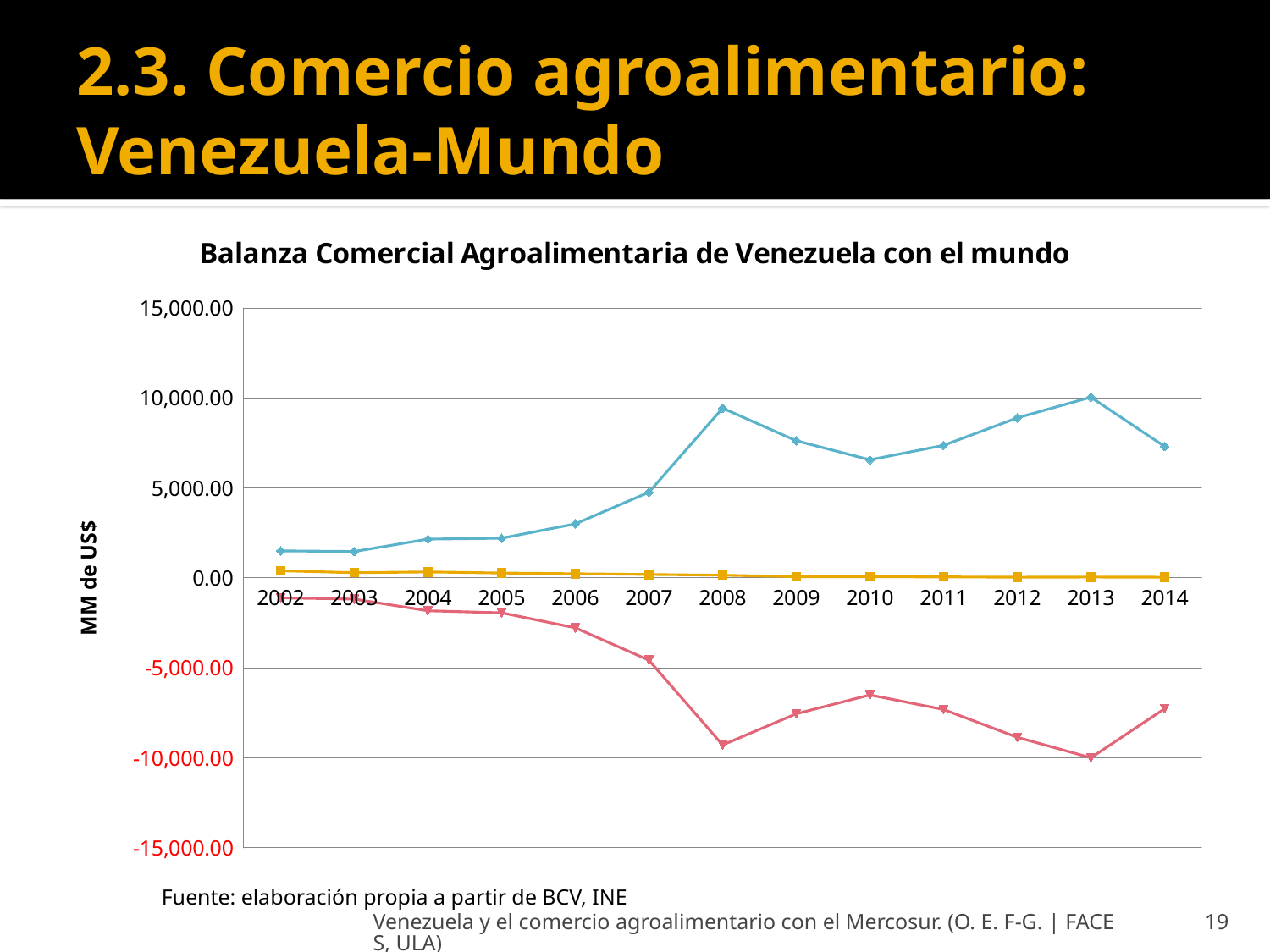
Is the value of the red line in 2013 greater or less than -5,000.00? less How many years are plotted along the x axis of the chart? 13 Does the blue line generally rise or fall from 2002 to 2013? rise Is the value of the red line in 2002 greater or less than -5,000.00? greater What is the label on the vertical axis of the chart? MM de US$ Is the value of the blue line in 2002 greater or less than 5,000.00? less What kind of chart is shown on the slide? line chart What is the title of the chart? Balanza Comercial Agroalimentaria de Venezuela con el mundo Which year has the larger value on the blue line, 2008 or 2009? 2008 In which year does the red line reach its lowest value? 2013 In which year does the blue line reach its highest value? 2013